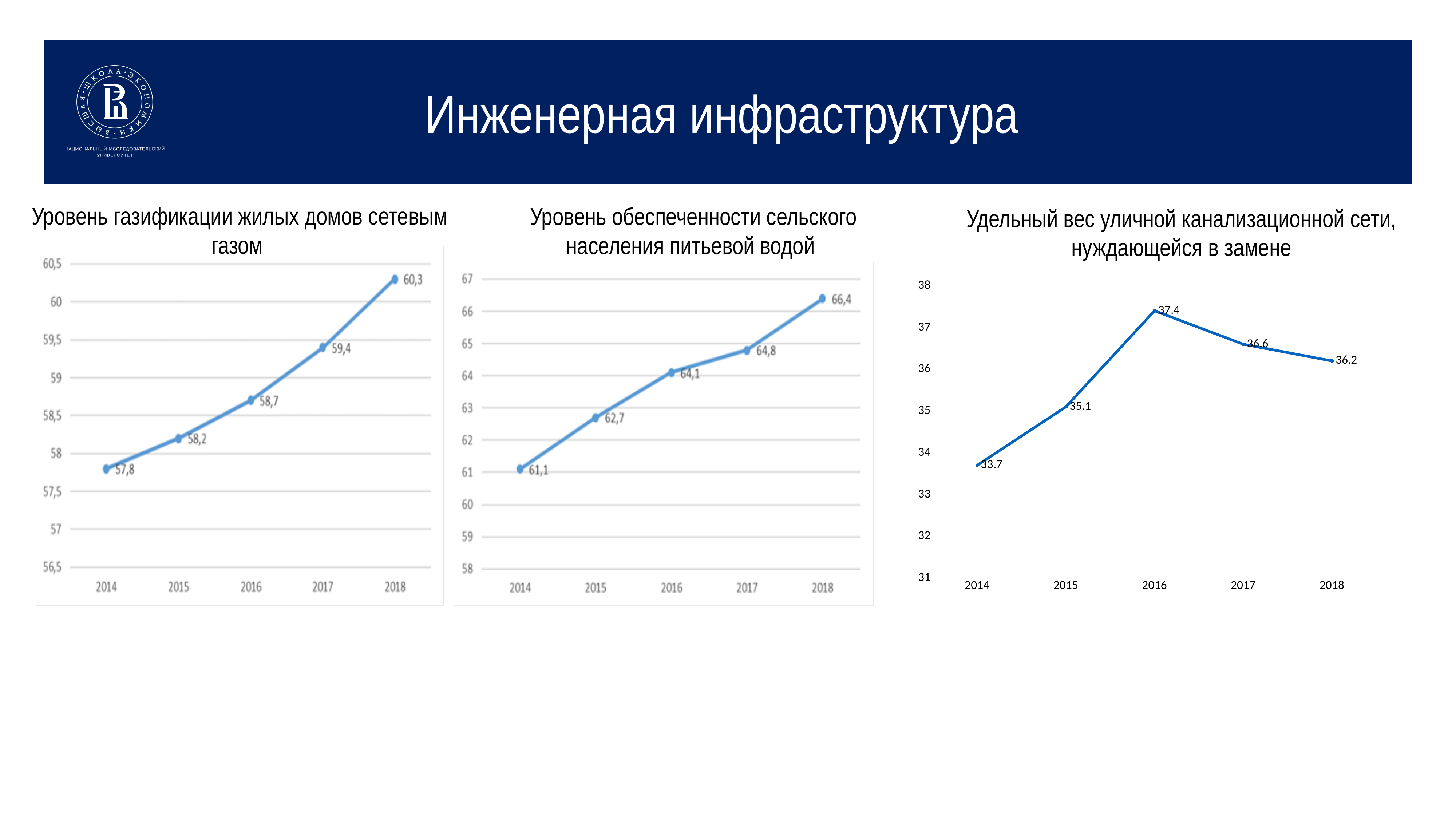
In the chart 'Уровень обеспеченности сельского населения питьевой водой', what is the value for 2016? 64,1 In the chart 'Уровень газификации жилых домов сетевым газом', what is the value for 2014? 57,8 In the chart 'Уровень газификации жилых домов сетевым газом', what is the value for 2018? 60,3 In the chart 'Удельный вес уличной канализационной сети, нуждающейся в замене', which is larger, the value for 2015 or the value for 2017? 2017 In the chart 'Уровень газификации жилых домов сетевым газом', which year has the lowest value? 2014 In the chart 'Уровень обеспеченности сельского населения питьевой водой', how many data points are plotted? 5 In the chart 'Уровень обеспеченности сельского населения питьевой водой', which year has the highest value? 2018 In the chart 'Удельный вес уличной канализационной сети, нуждающейся в замене', which year has the highest value? 2016 In the chart 'Удельный вес уличной канализационной сети, нуждающейся в замене', what is the value for 2016? 37.4 In the chart 'Уровень газификации жилых домов сетевым газом', do the values rise or fall from 2014 to 2018? rise In the chart 'Уровень обеспеченности сельского населения питьевой водой', what is the difference between the 2018 and 2014 values? 5,3 What kind of chart is 'Удельный вес уличной канализационной сети, нуждающейся в замене'? line chart